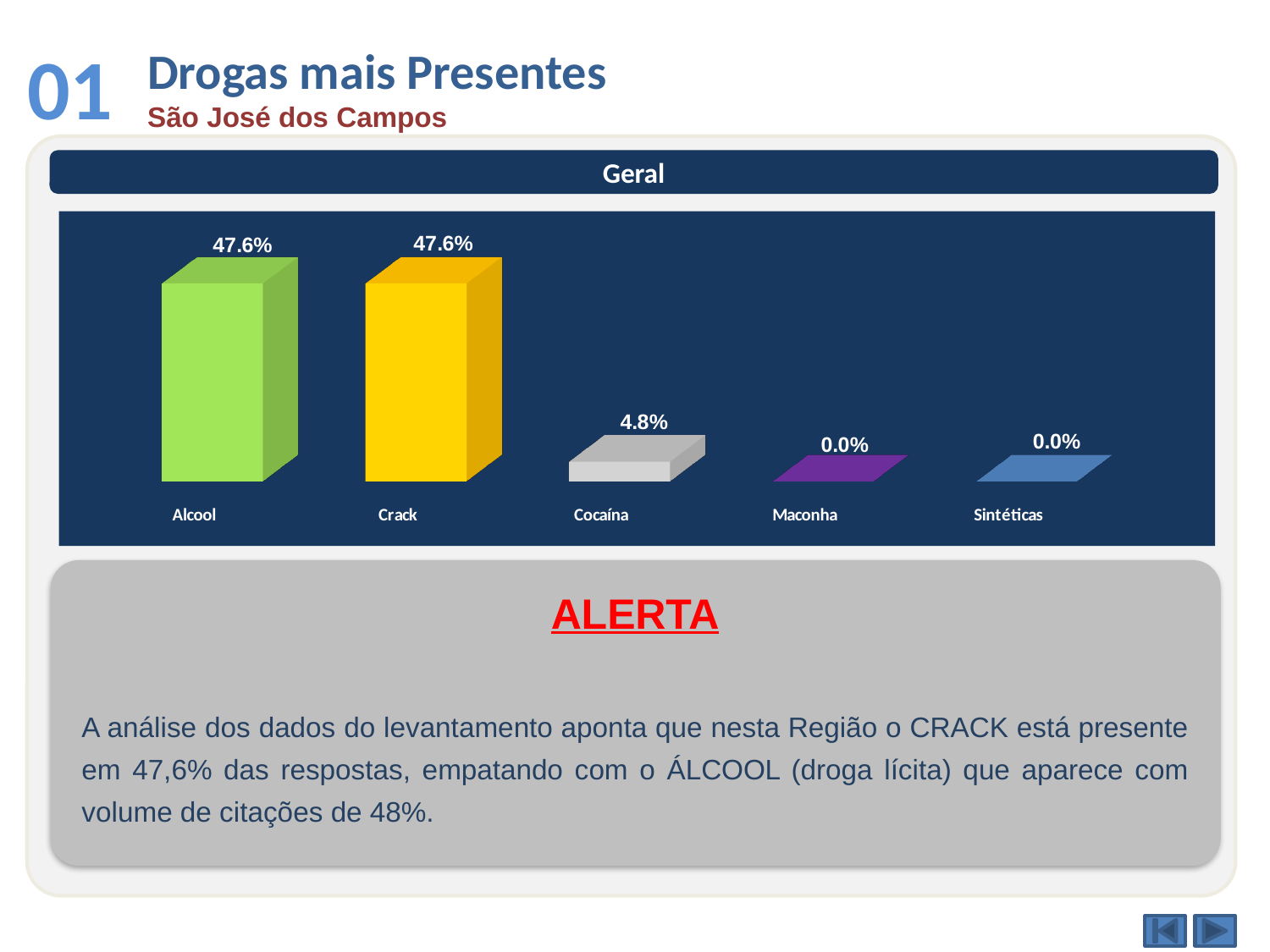
What is the difference between the values for Crack and Cocaína? 42.8% Which is larger, the value for Alcool or the value for Cocaína? Alcool What is the value for Maconha? 0.0% What colour is the bar for Crack? yellow What is the value for Sintéticas? 0.0% What is the value for Alcool? 47.6% What is the value for Cocaína? 4.8% What is the title shown above the chart? Geral How many categories are shown in the chart? 5 What kind of chart is shown on the slide? bar chart What is the value for Crack? 47.6% What is the difference between the values for Alcool and Crack? 0.0%